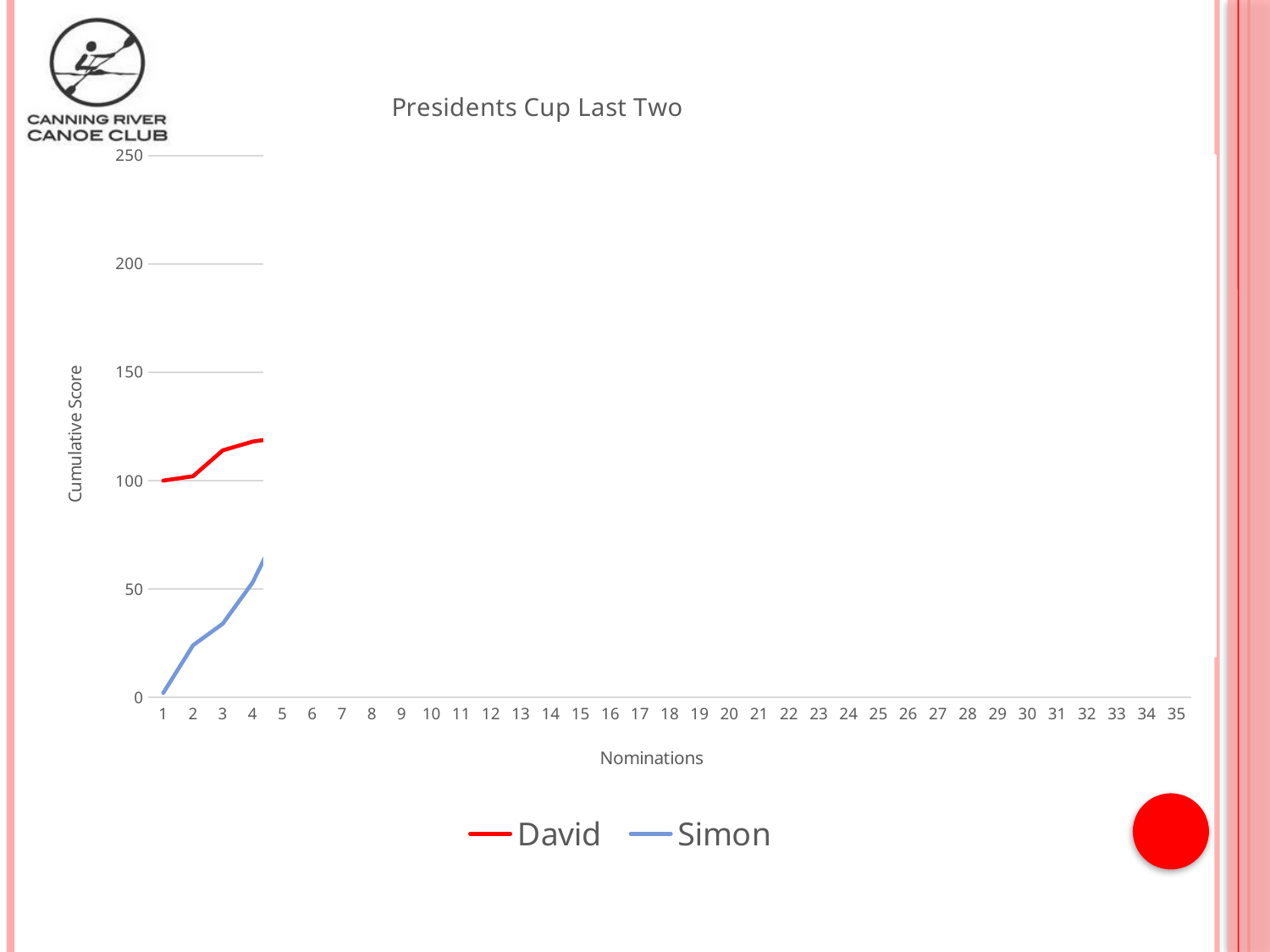
How many nominations are labelled along the x axis? 35 What kind of chart is shown on the slide? Line chart Does Simon's cumulative score rise or fall from nomination 1 to nomination 4? Rise At nomination 4, who has the higher cumulative score, David or Simon? David What is the title of the chart? Presidents Cup Last Two What is the label of the y axis? Cumulative Score Is David's cumulative score at nomination 4 greater or less than 150? less Is Simon's cumulative score at nomination 2 greater or less than 50? less What is David's cumulative score at nomination 1? 100 How many series does the legend list? 2